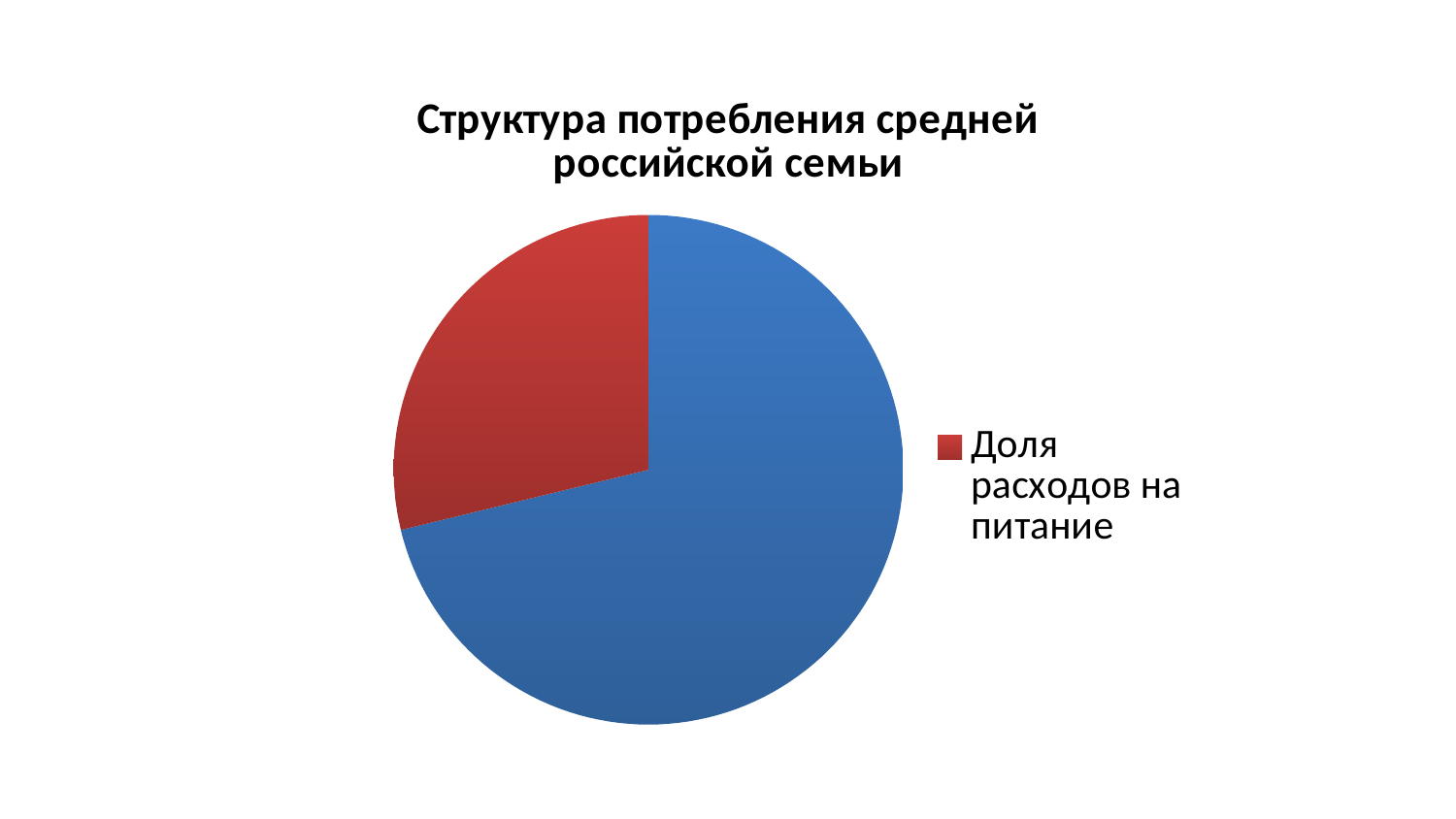
What kind of chart is shown on the slide? Pie chart Which slice is larger, the blue slice or the red slice? The blue slice Does the slice for "Доля расходов на питание" take up more or less than half of the pie? Less Which colour represents "Доля расходов на питание" in the chart? Red What is the legend entry shown next to the chart? Доля расходов на питание Does the blue slice take up more or less than half of the pie? More Is the slice for "Доля расходов на питание" the largest or the smallest slice of the pie? The smallest How many entries does the legend list? 1 How many slices does the pie chart have? 2 What is the title of the chart? Структура потребления средней российской семьи